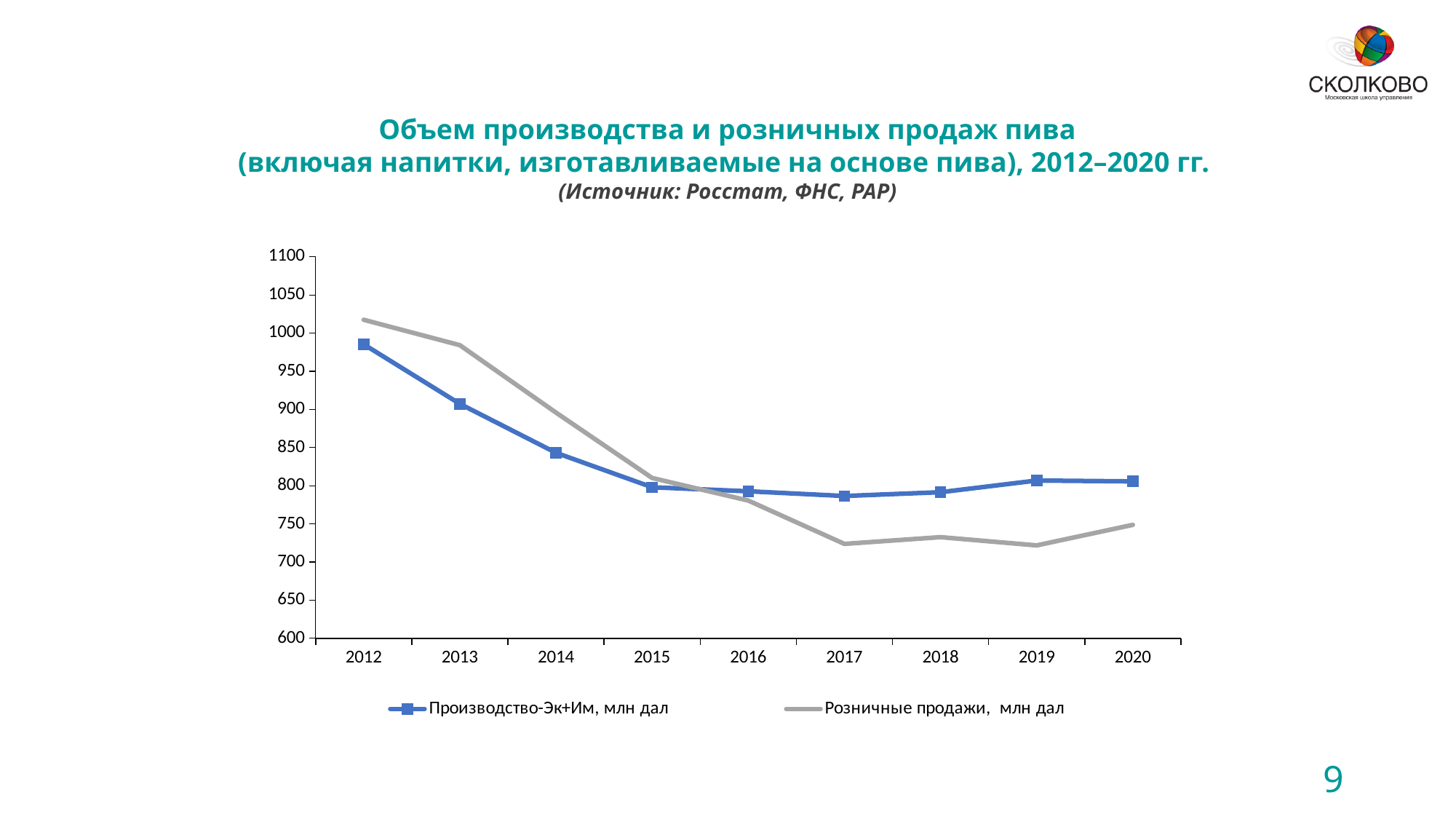
How many series does the legend list? 2 In 2017, which series has the larger value: Производство-Эк+Им, млн дал or Розничные продажи, млн дал? Производство-Эк+Им, млн дал In which year is the value for Производство-Эк+Им, млн дал highest? 2012 Which sources are cited in the chart title? Росстат, ФНС, РАР Does the value for Розничные продажи, млн дал rise or fall from 2012 to 2017? fall In which year is the value for Розничные продажи, млн дал highest? 2012 How many years are plotted along the x axis? 9 Is the value for Розничные продажи, млн дал in 2012 greater or less than 1000? greater What kind of chart is shown on the slide? line chart Is the value for Производство-Эк+Им, млн дал in 2012 greater or less than 950? greater Is the value for Розничные продажи, млн дал in 2017 greater or less than 750? less In 2013, which series has the larger value: Производство-Эк+Им, млн дал or Розничные продажи, млн дал? Розничные продажи, млн дал